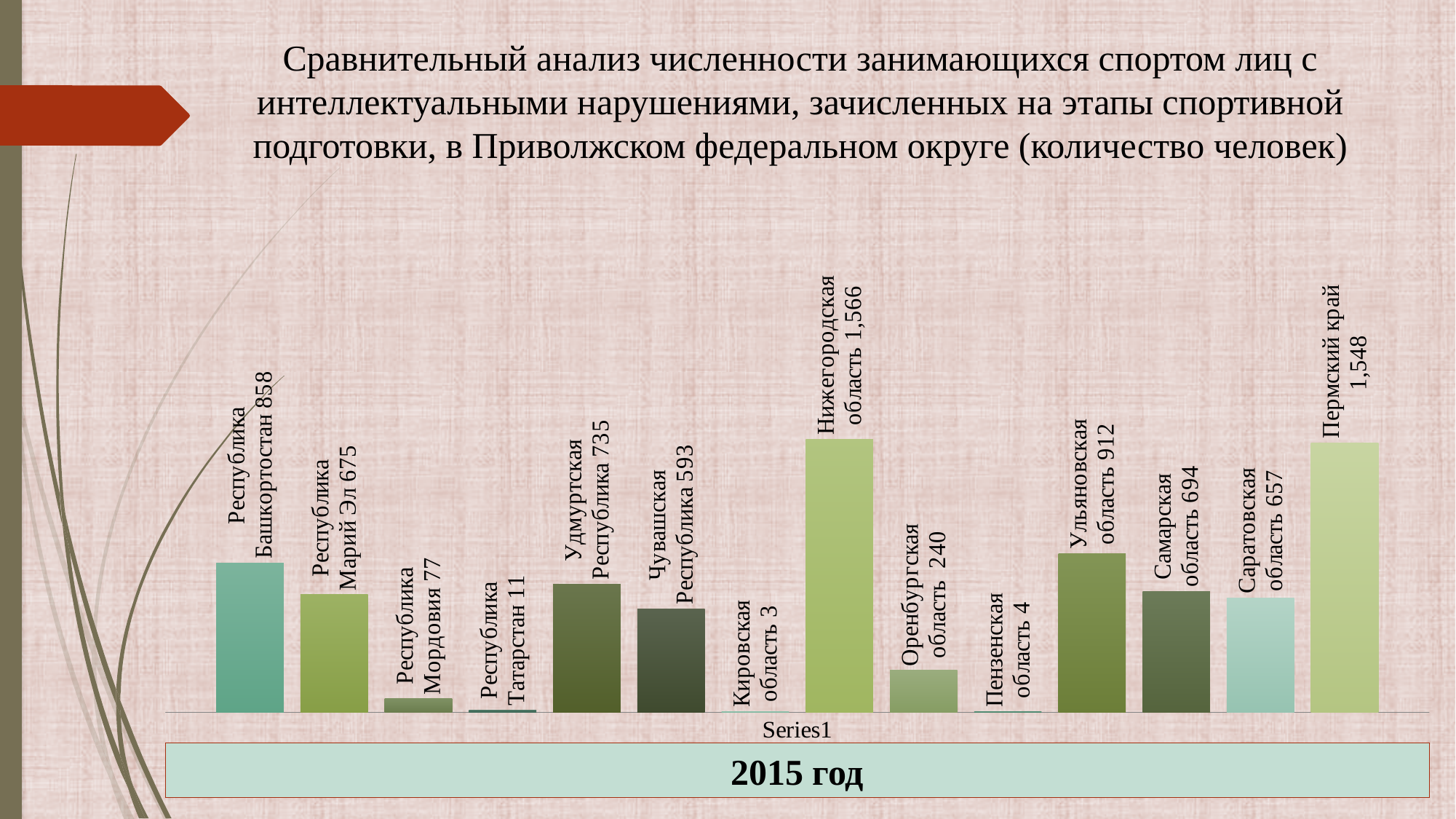
How many regions are shown in the chart? 14 What is the value for Оренбургская область? 240 What is the difference between the values for Нижегородская область and Пермский край? 18 Which region has the highest value? Нижегородская область Which region has the lowest value? Кировская область What is the value for Нижегородская область? 1,566 What is the difference between the values for Ульяновская область and Самарская область? 218 What year is indicated in the box below the chart? 2015 год What kind of chart is shown on the slide? bar chart What is the value for Республика Татарстан? 11 Which is larger, the value for Удмуртская Республика or the value for Чувашская Республика? Удмуртская Республика What is the value for Республика Башкортостан? 858